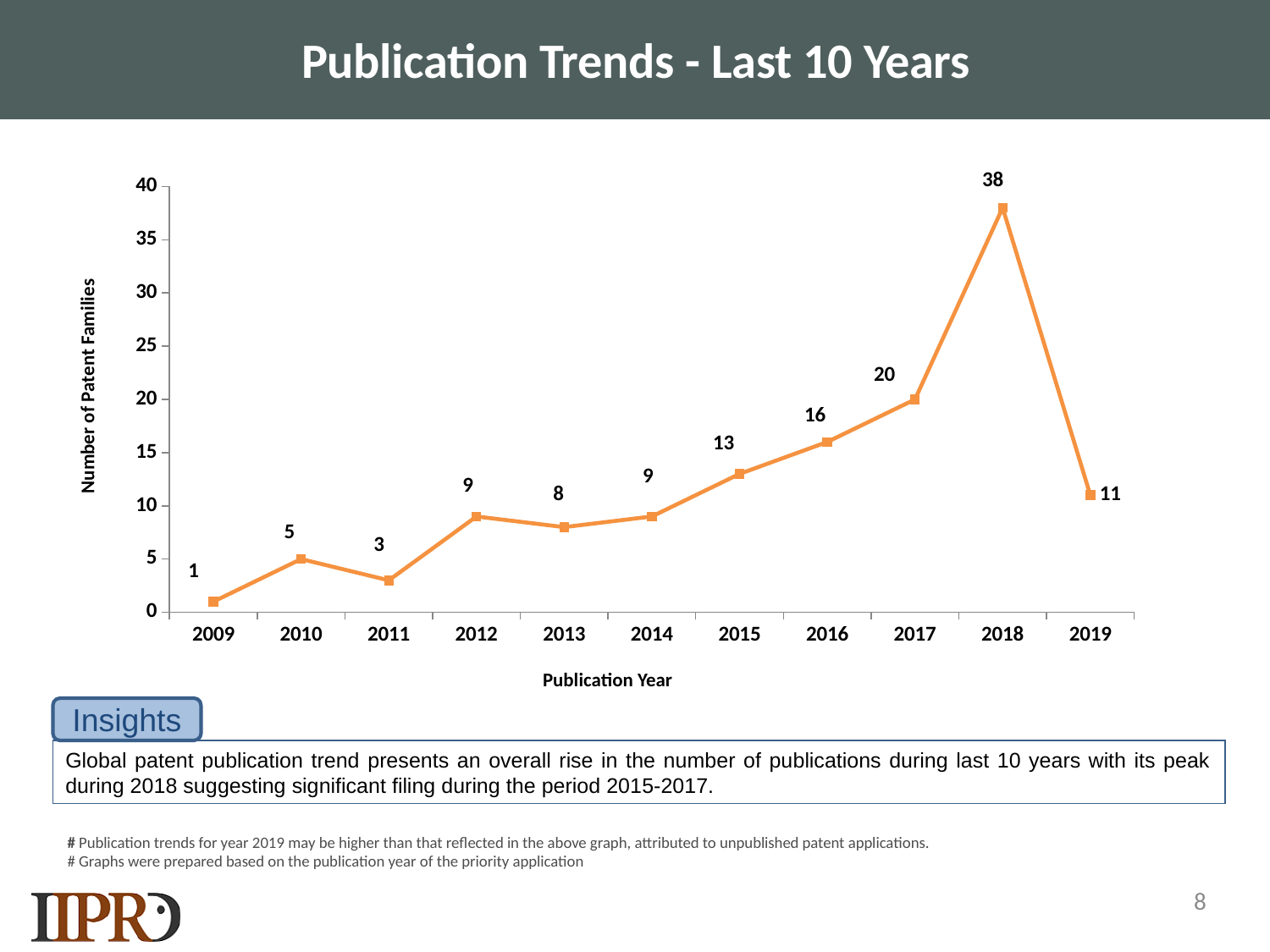
Which publication year has the highest number of patent families? 2018 How many publication years are plotted on the chart? 11 How many patent families were published in 2015? 13 Which year has more patent families, 2012 or 2013? 2012 What is the difference in the number of patent families between 2018 and 2017? 18 What is the label of the x axis? Publication Year Which publication year has the lowest number of patent families? 2009 What is the number of patent families for 2019? 11 What is the label of the y axis? Number of Patent Families Do the values rise or fall from 2014 to 2018? Rise What is the number of patent families for 2011? 3 What kind of chart is shown on the slide? Line chart